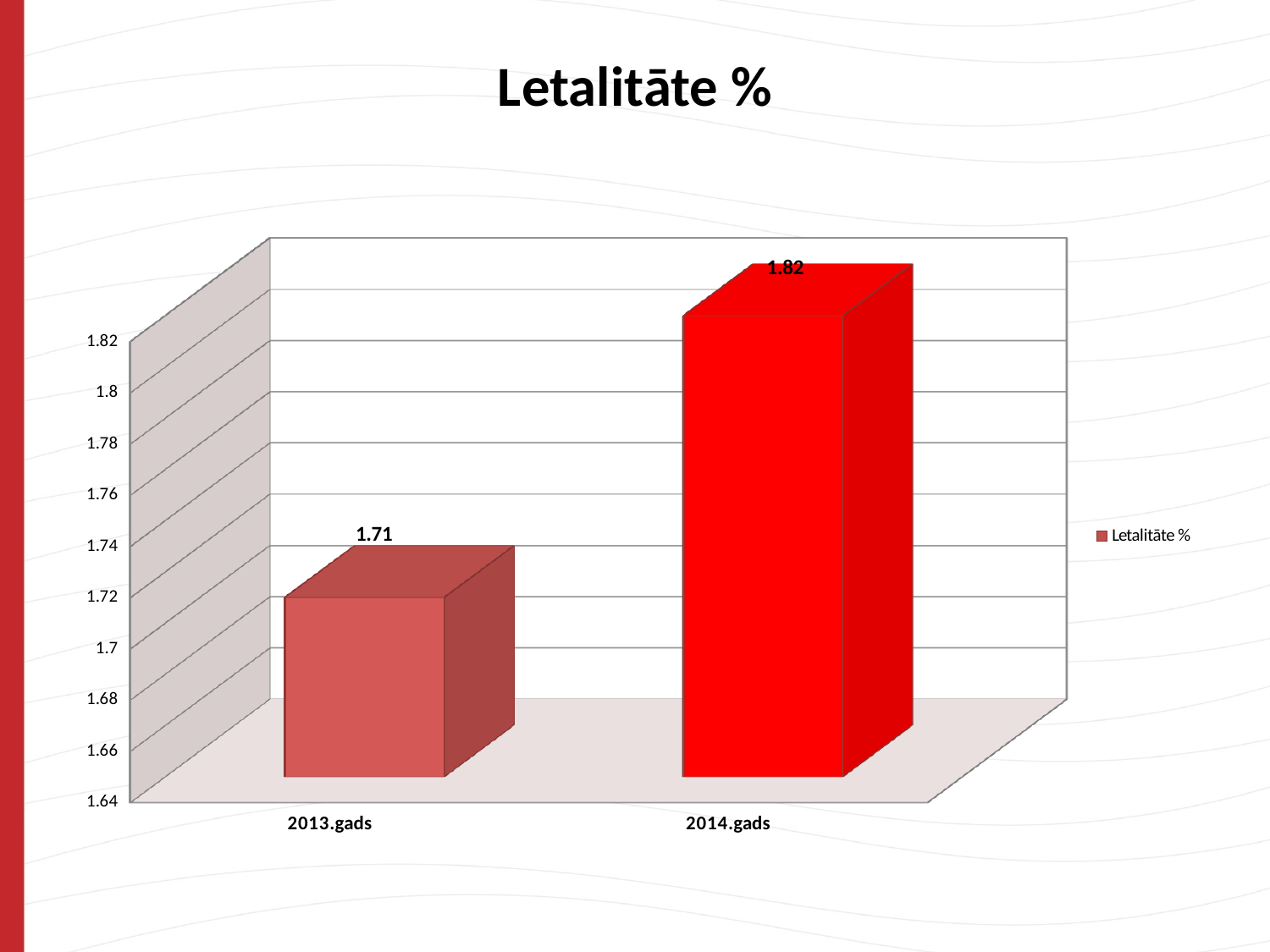
Which is larger, the value for 2013.gads or the value for 2014.gads? 2014.gads What is the value for 2014.gads? 1.82 How many categories are shown on the x axis? 2 Which category has the highest value? 2014.gads How many series does the legend list? 1 Which category has the lowest value? 2013.gads Is the value for 2014.gads greater or less than 1.8? greater What kind of chart is shown on the slide? bar chart What is the value for 2013.gads? 1.71 Do the values rise or fall from 2013.gads to 2014.gads? rise Is the value for 2013.gads greater or less than 1.74? less What is the difference between the values for 2014.gads and 2013.gads? 0.11